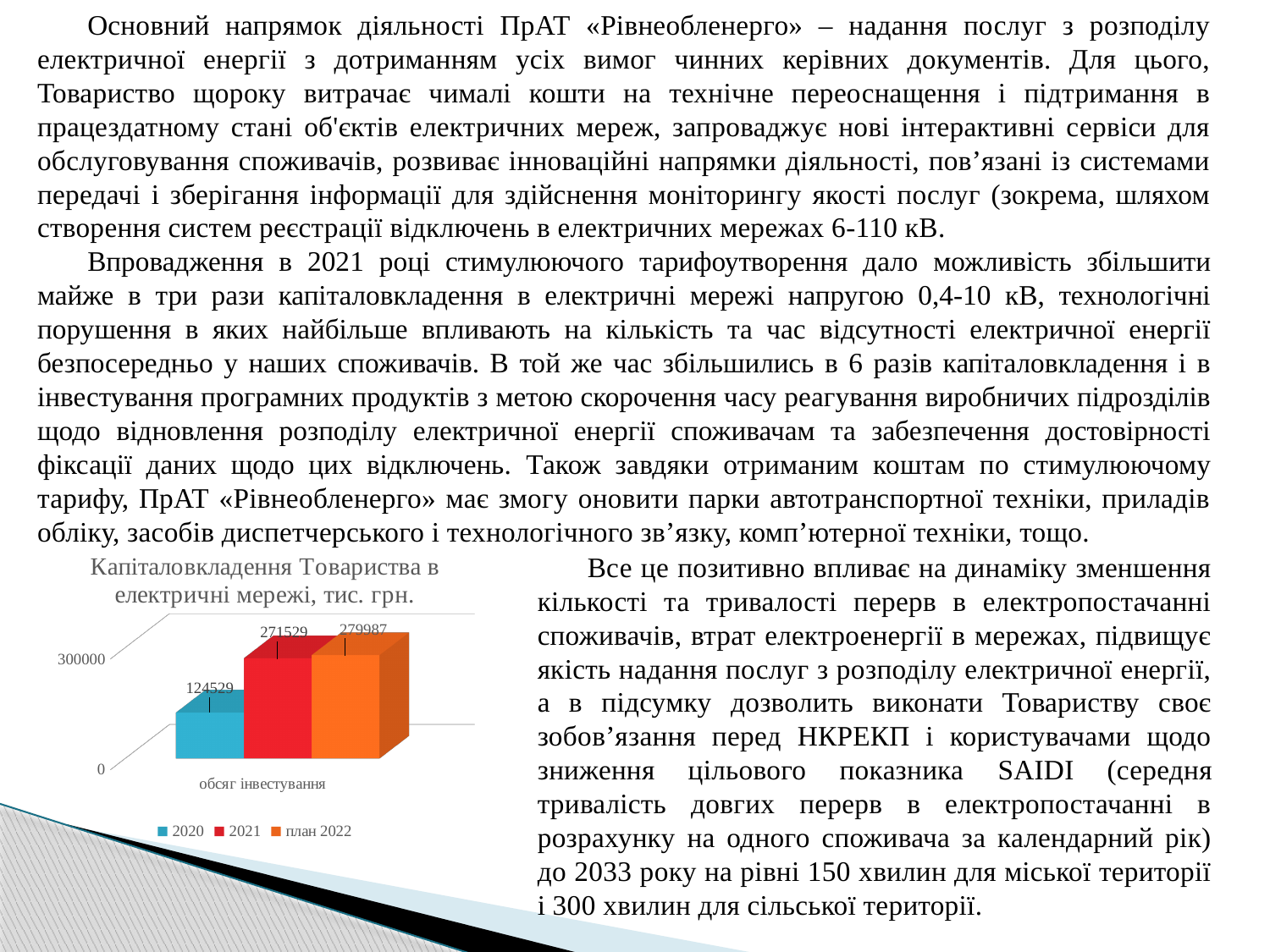
How many series does the legend list? 3 Which is larger, the value for 2020 or the value for 2021? 2021 Which series has the lowest value in the chart? 2020 Which series has the highest value in the chart? план 2022 What kind of chart is shown on the slide? bar chart What is the value for 2021 in the chart? 271529 Is the value for 2020 greater or less than 300000? less What is the value for 2020 in the chart 'Капіталовкладення Товариства в електричні мережі, тис. грн.'? 124529 What is the difference between the 'план 2022' value and the 2021 value? 8458 What is the category label shown on the x axis of the chart? обсяг інвестування What is the value for 'план 2022' in the chart? 279987 What is the difference between the 2021 value and the 2020 value? 147000